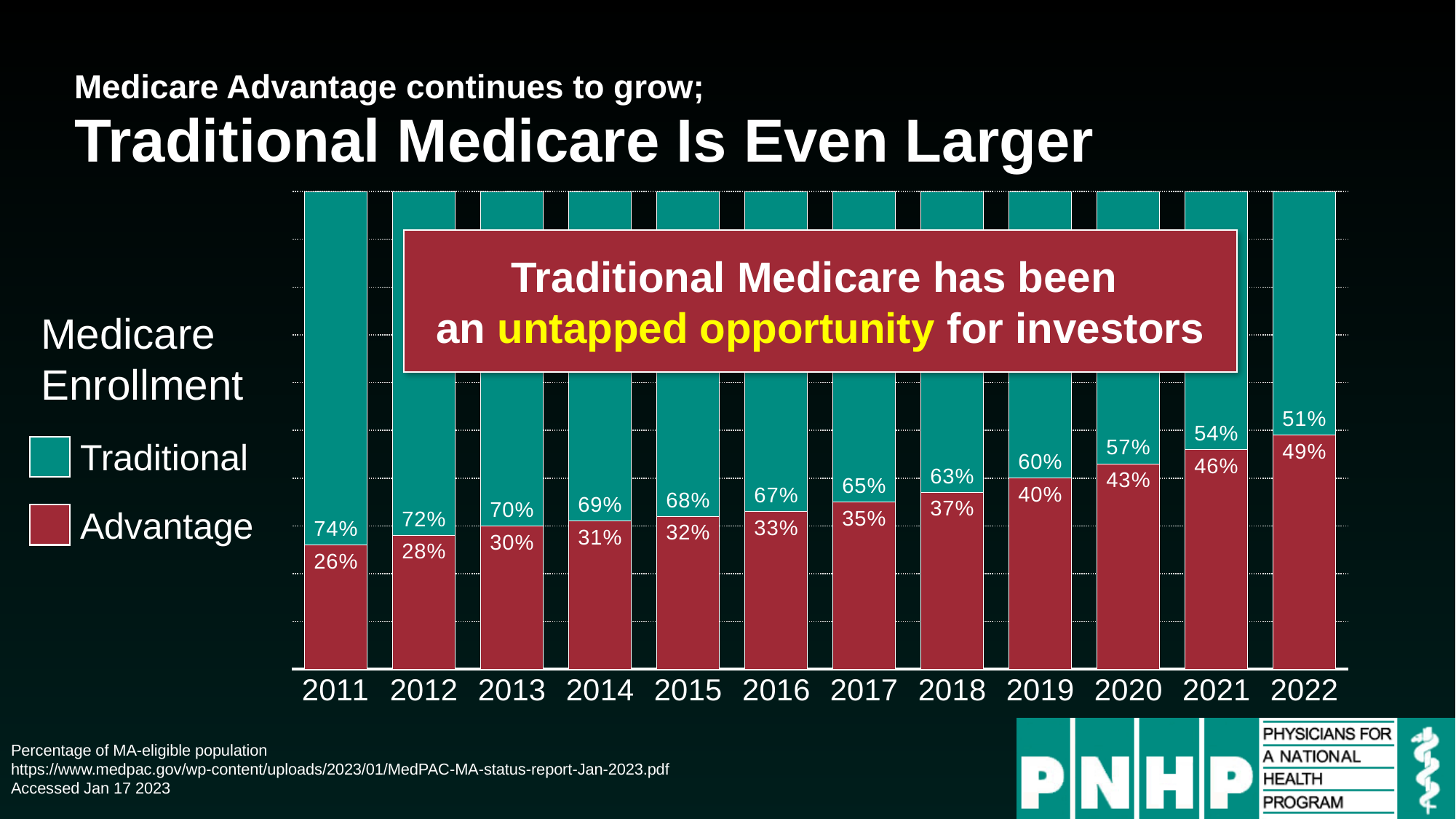
How many series does the legend list? 2 What is the Traditional value for 2015? 68% What is the difference between the Traditional and Advantage values in 2019? 20% What is the Advantage value for 2017? 35% What kind of chart is shown on the slide? Stacked bar chart How many years are shown on the x axis? 12 Which year has the lowest Traditional value? 2022 Which year has the highest Advantage value? 2022 What is the Traditional value for 2022? 51% Which is larger in 2021, the Traditional value or the Advantage value? Traditional Do the Advantage values rise or fall from 2011 to 2022? Rise What is the Advantage value for 2011? 26%